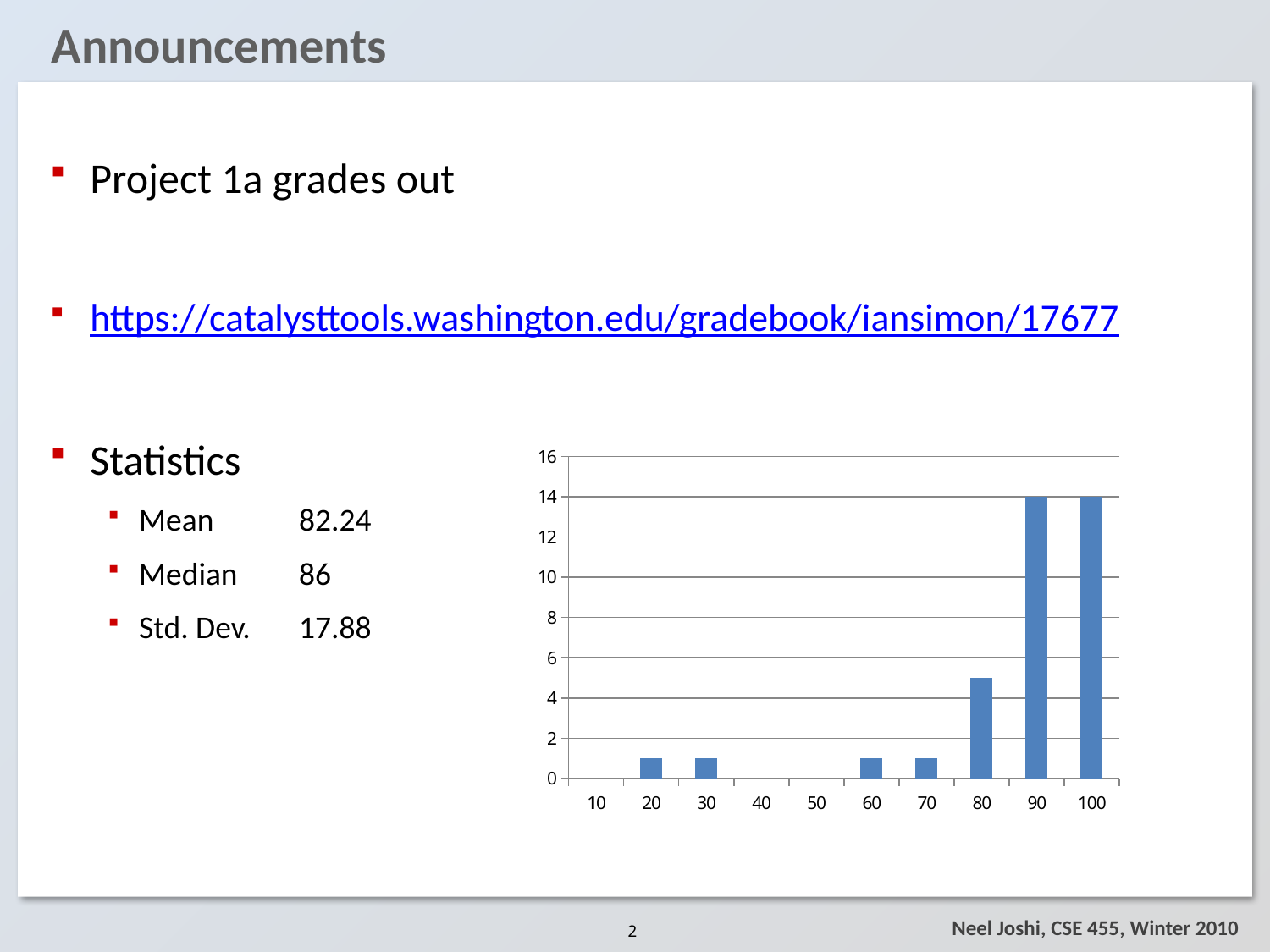
What kind of chart is shown on the slide? bar chart Which has the larger value, category 80 or category 90? 90 How many categories have a visible bar above zero? 7 Is the value for category 80 greater or less than 4? greater Do the values generally rise or fall moving from left to right along the x axis? rise What is the value of the bar for category 90? 14 Is the value for category 20 greater or less than 2? less Is the value for category 80 greater or less than 6? less What is the value of the bar for category 100? 14 What is the difference between the values for categories 90 and 100? 0 How many categories are labelled on the x axis? 10 Which has the larger value, category 20 or category 80? 80